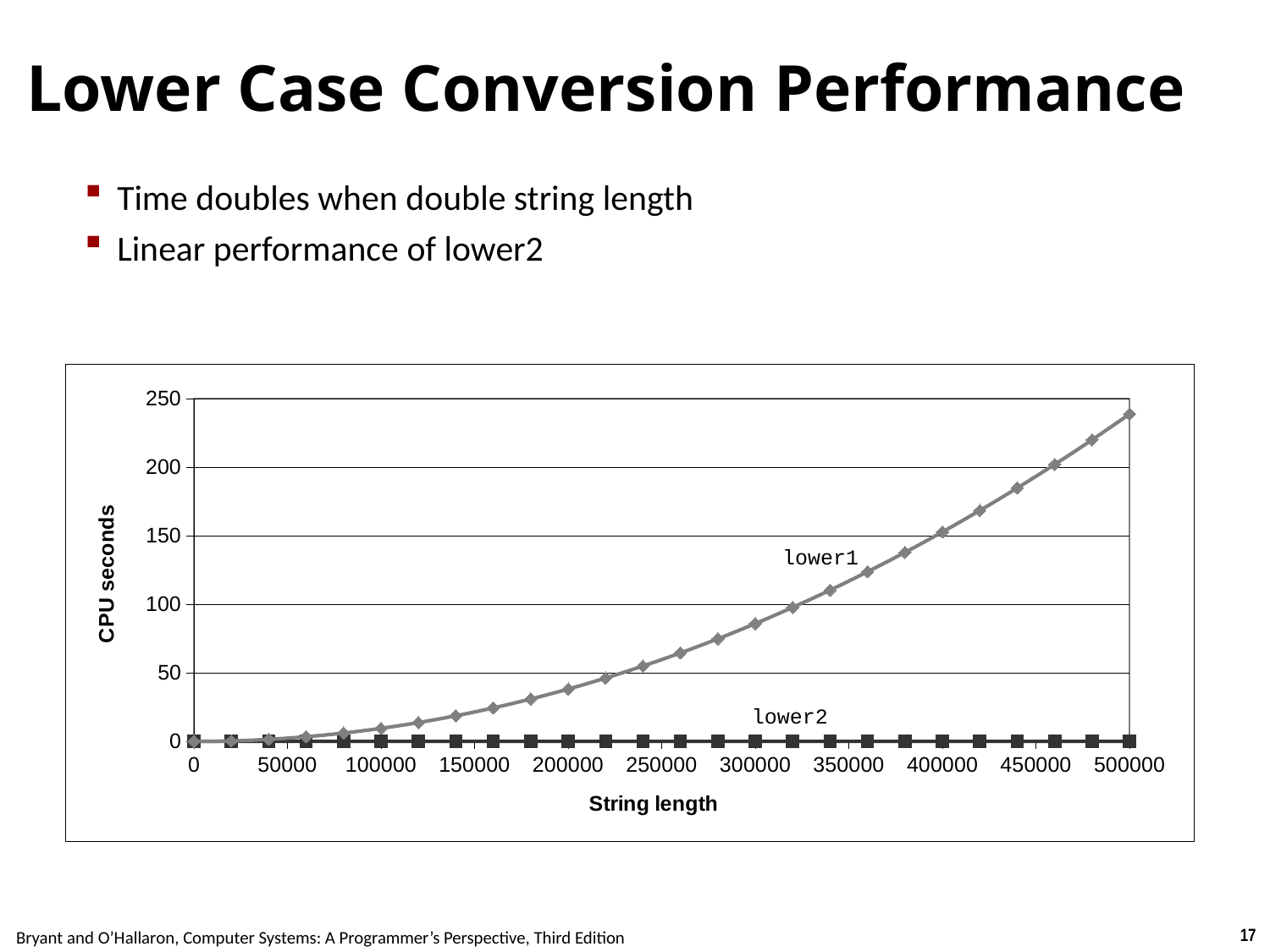
What are the names of the two series plotted in the chart? lower1 and lower2 Is the value of lower1 at string length 400000 greater or less than 100? greater What kind of chart is shown on the slide? line chart Is the value of lower1 at string length 200000 greater or less than 50? less How many data series are plotted in the chart? 2 Which series reaches the highest CPU seconds value in the chart? lower1 Does the lower1 series rise or fall as string length increases? rise Is the value of lower2 at string length 500000 greater or less than 50? less What is the label of the y axis? CPU seconds At string length 500000, which series has the larger CPU seconds value, lower1 or lower2? lower1